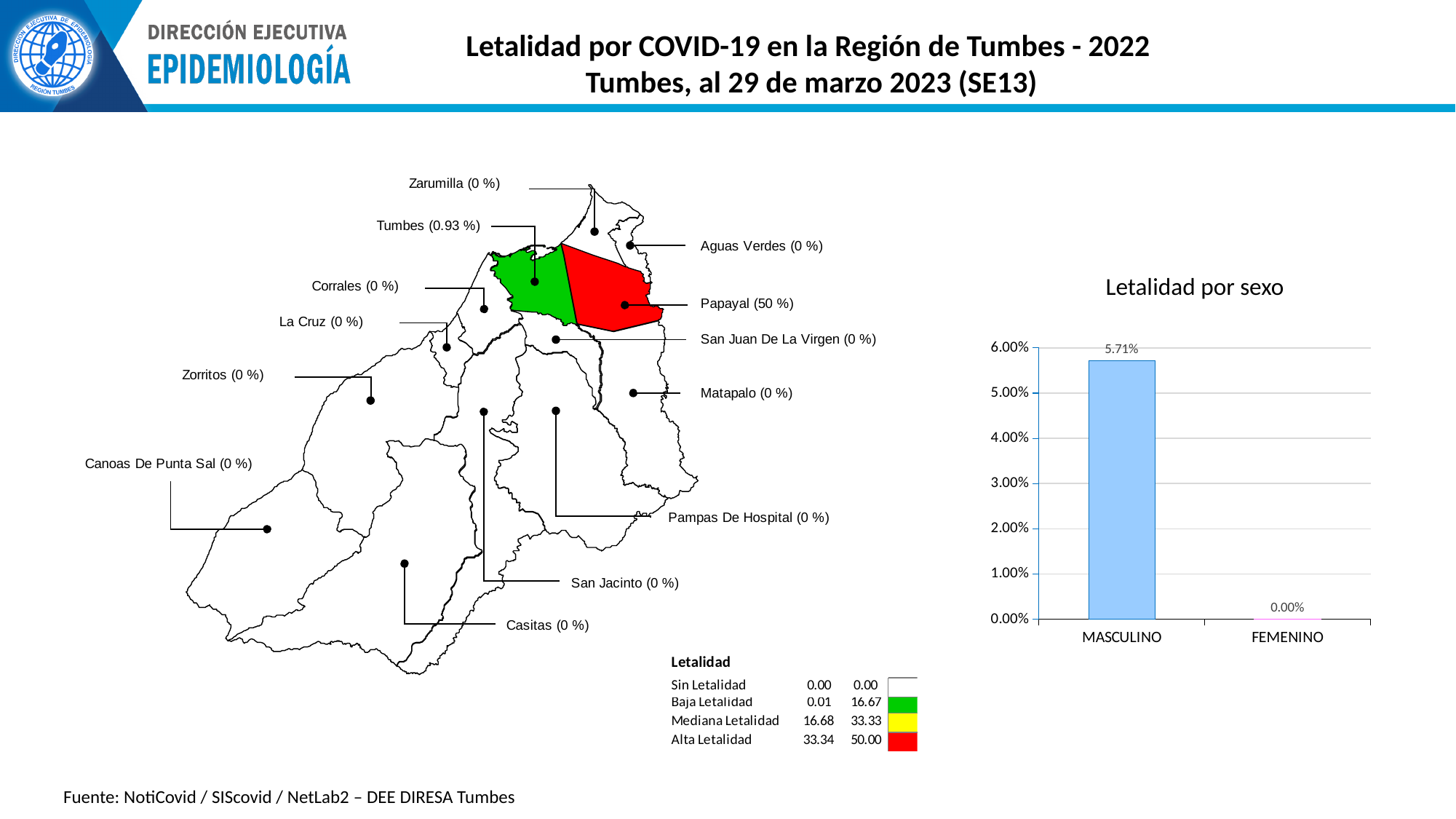
In the 'Letalidad por sexo' chart, what is the difference between the MASCULINO and FEMENINO values? 5.71% On the map, what lethality value is shown for Tumbes? 0.93 % In the 'Letalidad por sexo' chart, which category has the highest value? MASCULINO On the map, what lethality value is shown for Papayal? 50 % In the 'Letalidad por sexo' chart, what is the value for FEMENINO? 0.00% What kind of chart is 'Letalidad por sexo'? Bar chart What is the title of the bar chart on the right side of the slide? Letalidad por sexo In the 'Letalidad por sexo' chart, is the value for MASCULINO greater or less than 5.00%? greater In the 'Letalidad por sexo' chart, how many categories are shown on the x axis? 2 In the 'Letalidad por sexo' chart, what is the value for MASCULINO? 5.71% In the 'Letalidad por sexo' chart, what is the highest value shown on the y axis? 6.00% In the 'Letalidad por sexo' chart, which category has the lowest value? FEMENINO